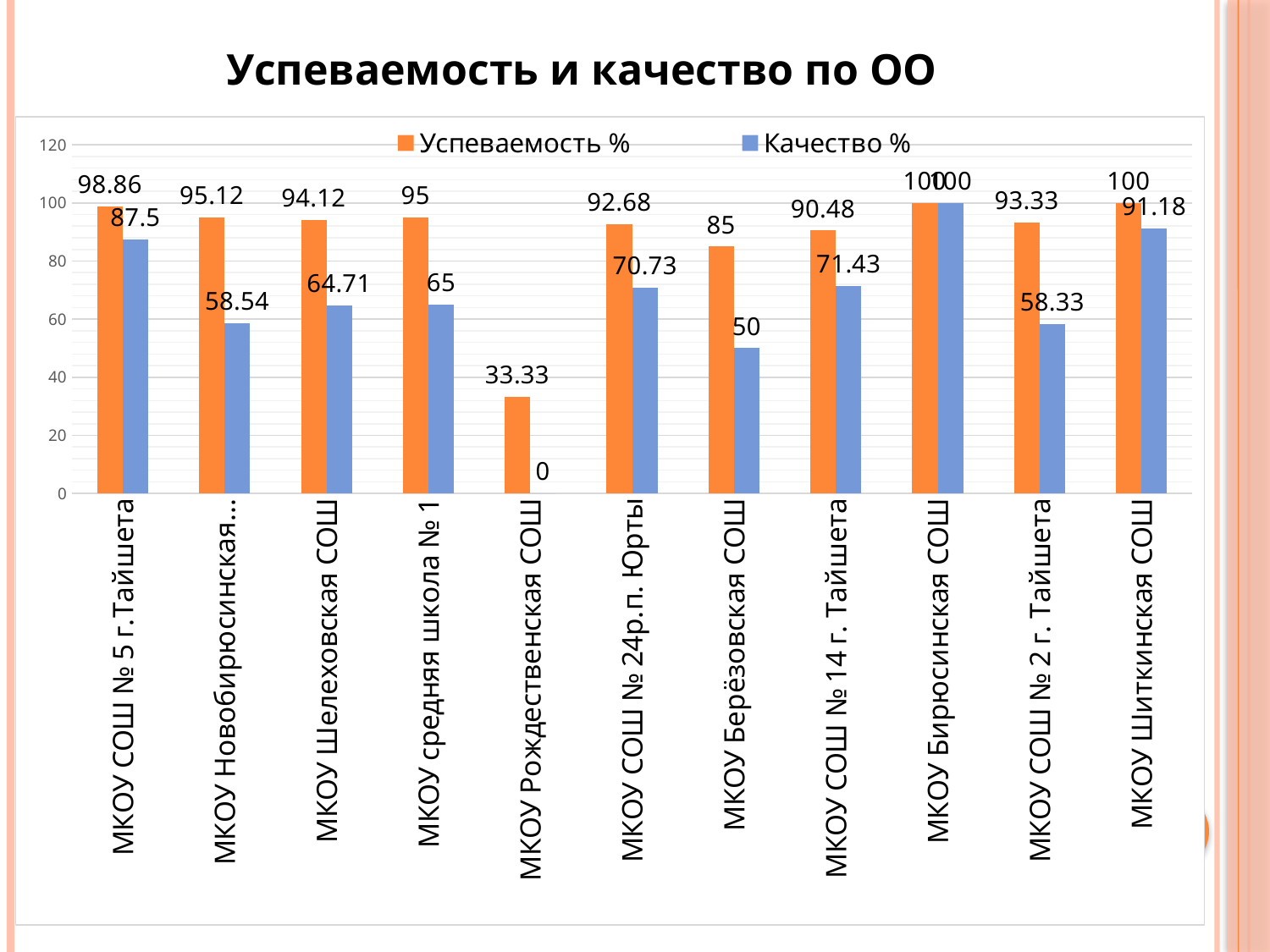
How many schools are shown on the x axis of the chart? 11 How many series does the legend list? 2 Which school has the lowest Успеваемость % value? МКОУ Рождественская СОШ What is the Качество % value for МКОУ СОШ № 24р.п. Юрты? 70.73 What is the difference between the Успеваемость % and Качество % values for МКОУ Шелеховская СОШ? 29.41 What is the Качество % value for МКОУ Рождественская СОШ? 0 What is the Успеваемость % value for МКОУ СОШ № 5 г.Тайшета? 98.86 What kind of chart is shown on the slide? Bar chart Which school has the highest Качество % value? МКОУ Бирюсинская СОШ What is the Успеваемость % value for МКОУ Берёзовская СОШ? 85 What is the title of the chart? Успеваемость и качество по ОО Which is larger: the Качество % value for МКОУ СОШ № 14 г. Тайшета or for МКОУ СОШ № 2 г. Тайшета? МКОУ СОШ № 14 г. Тайшета